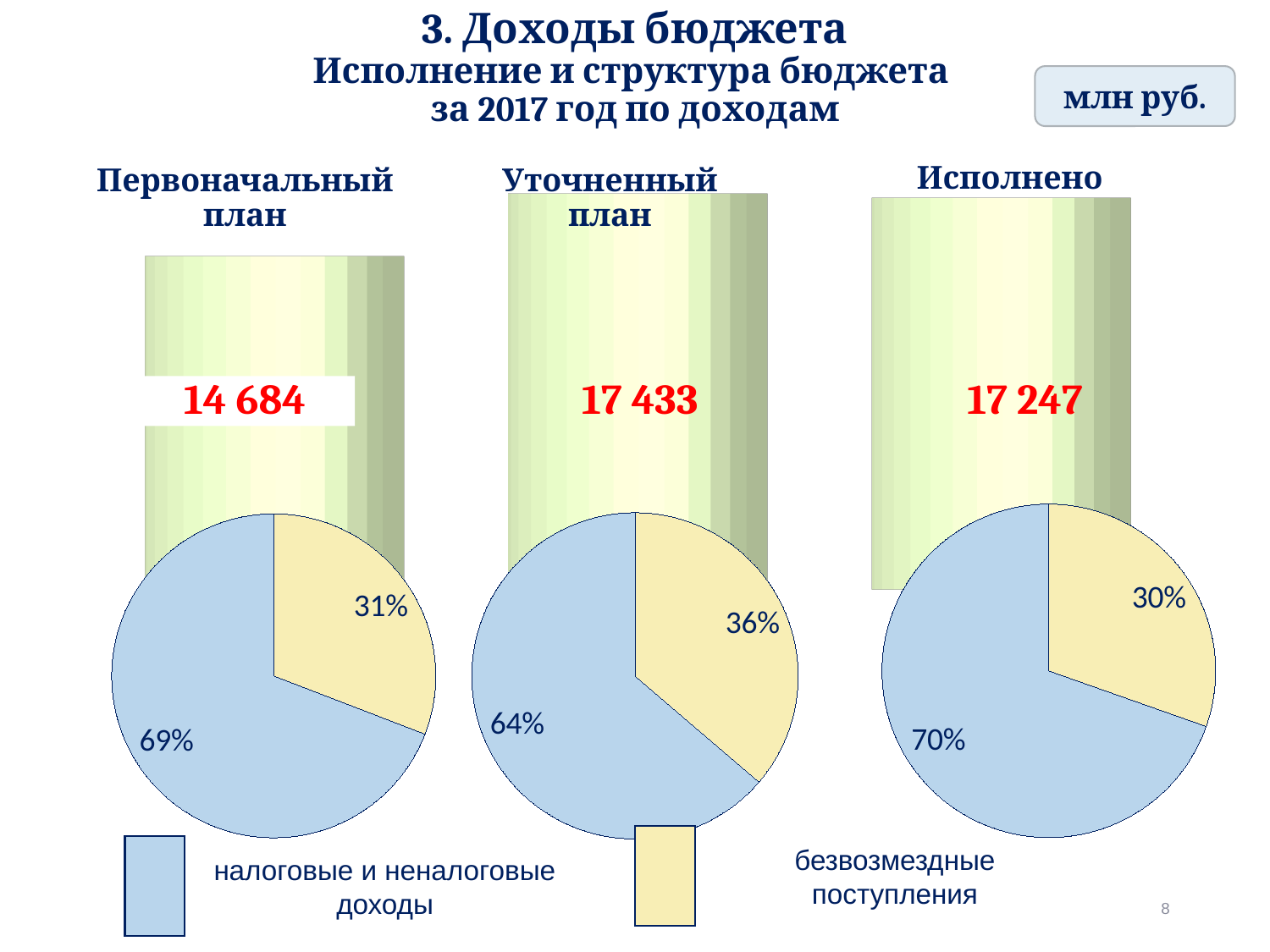
In the pie chart under "Уточненный план", what share is shown for "налоговые и неналоговые доходы"? 64% What total value (млн руб.) is printed on the "Исполнено" column? 17 247 What total value (млн руб.) is printed on the "Первоначальный план" column? 14 684 What total value (млн руб.) is printed on the "Уточненный план" column? 17 433 In the pie chart under "Первоначальный план", what share is shown for "налоговые и неналоговые доходы"? 69% In the pie chart under "Исполнено", what share is shown for "безвозмездные поступления"? 30% Which of the three columns (Первоначальный план, Уточненный план, Исполнено) has the highest value? Уточненный план Which pie chart has the largest share for "безвозмездные поступления"? Уточненный план What is the difference between the "Уточненный план" value and the "Исполнено" value? 186